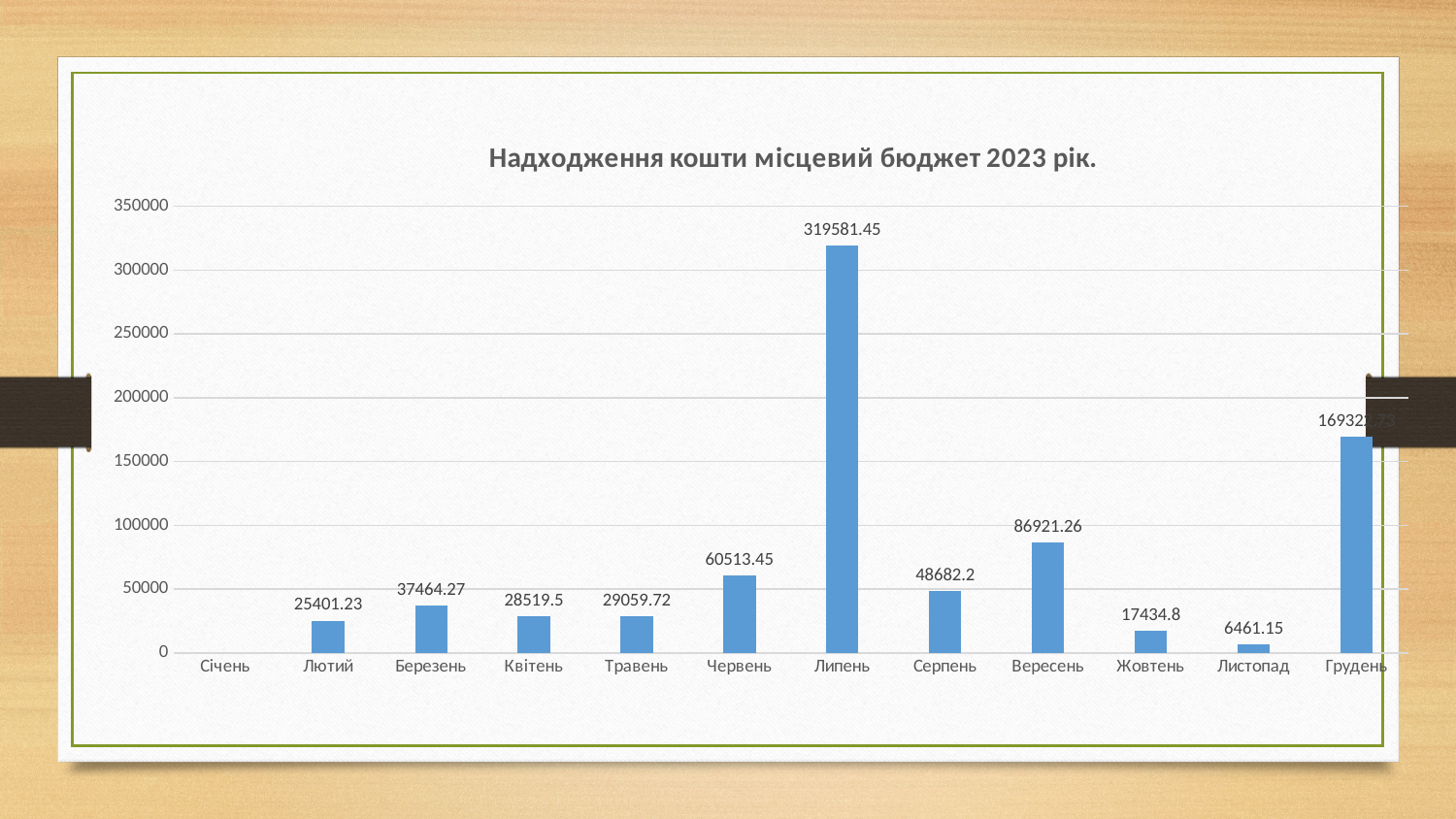
How many months are shown on the x axis? 12 What is the value for Лютий? 25401.23 What is the value for Липень? 319581.45 What is the difference between the values for Вересень and Серпень? 38239.06 What is the title of the chart? Надходження кошти місцевий бюджет 2023 рік. Which month has the highest value? Липень What is the difference between the values for Червень and Лютий? 35112.22 What kind of chart is shown on the slide? bar chart Is the value for Грудень greater or less than 150000? greater What is the value for Листопад? 6461.15 Which is larger, the value for Березень or the value for Квітень? Березень What is the value for Вересень? 86921.26